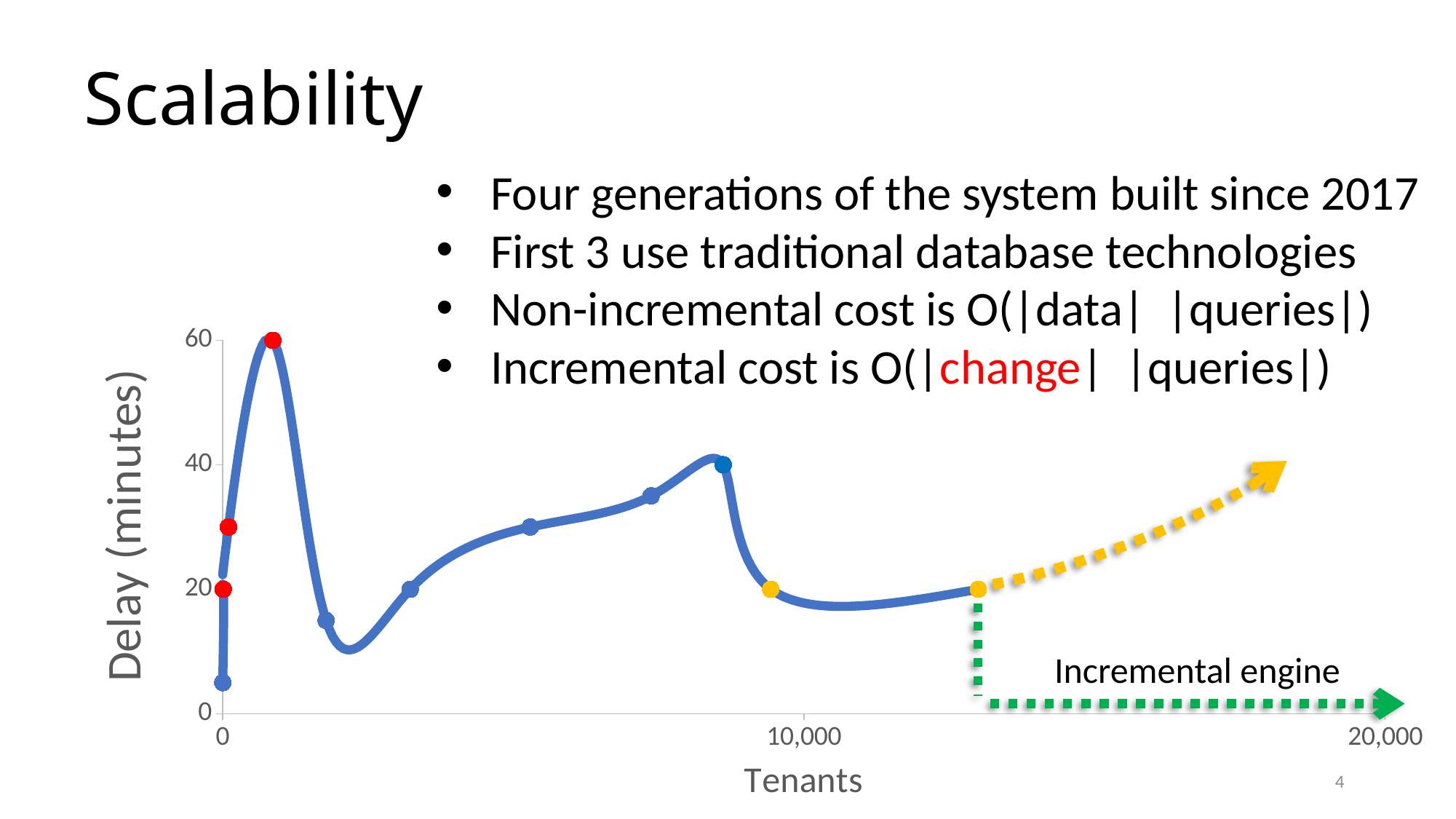
What is the label of the x axis of the chart? Tenants What is the highest delay value reached by the curve, as read from the y axis? 60 What is the largest tick value shown on the x axis? 20,000 Is the delay at the peak of the curve greater or less than 40 minutes? greater What kind of chart is shown on the slide? line chart Which is larger: the delay at the red peak point or the delay at the blue point just before 10,000 tenants? the red peak point Is the delay at the yellow point near 10,000 tenants greater or less than 40 minutes? less Is the delay at 0 tenants (the first point) greater or less than 20 minutes? less What is the label of the y axis of the chart? Delay (minutes) Does the delay rise or fall immediately after the red peak point as tenants increase? fall